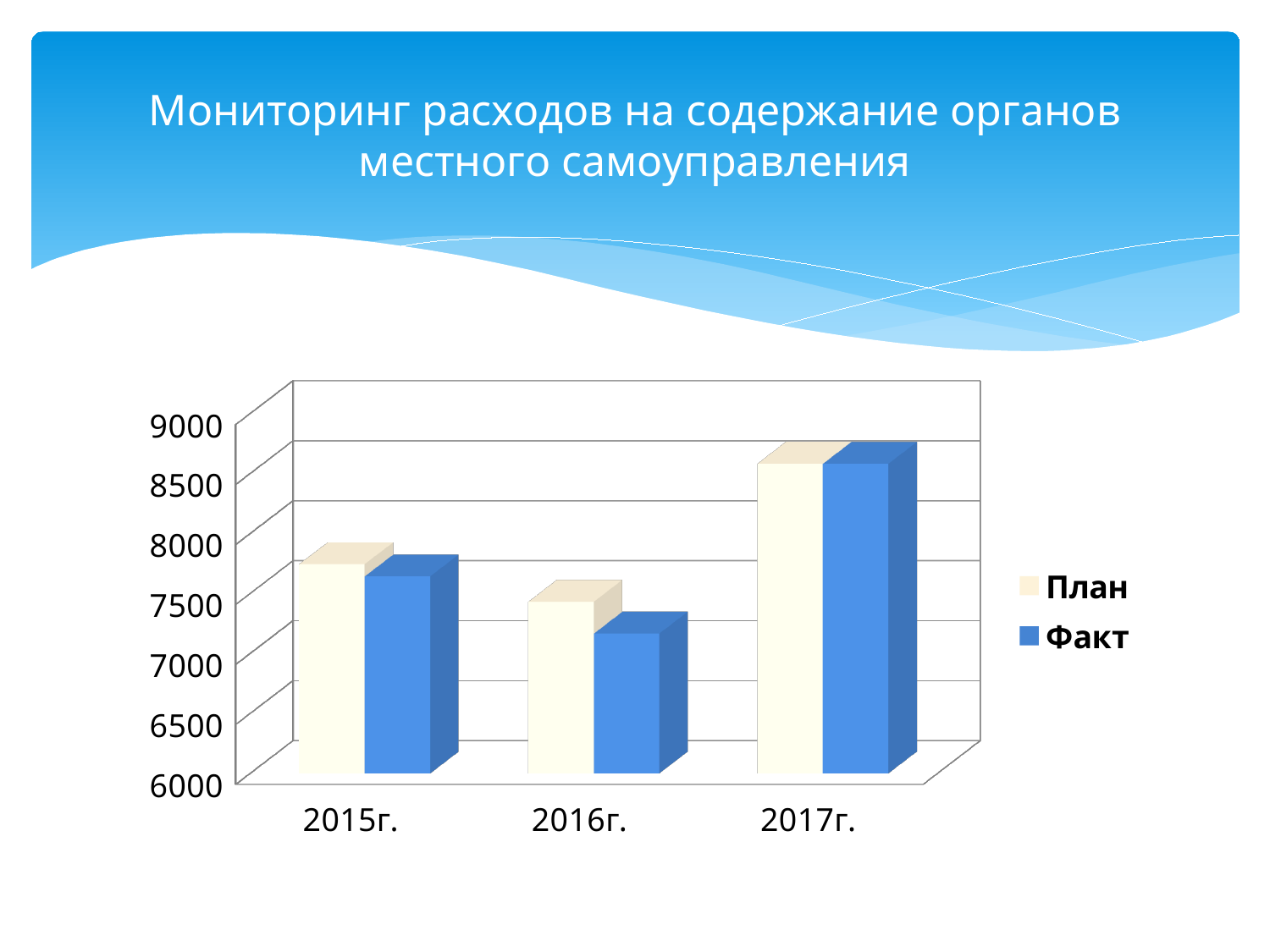
Does the Факт value rise or fall from 2015г. to 2016г.? fall In 2016г., which is larger, План or Факт? План Which series are listed in the legend? План, Факт Is the Факт value for 2016г. greater or less than 7500? less Is the Факт value for 2017г. greater or less than 8000? greater Is the План value for 2015г. greater or less than 7500? greater How many series does the legend list? 2 What kind of chart is shown on the slide? bar chart What is the title of the slide? Мониторинг расходов на содержание органов местного самоуправления In which year is the План value highest? 2017г. In which year is the Факт value lowest? 2016г. How many categories are shown on the x axis? 3